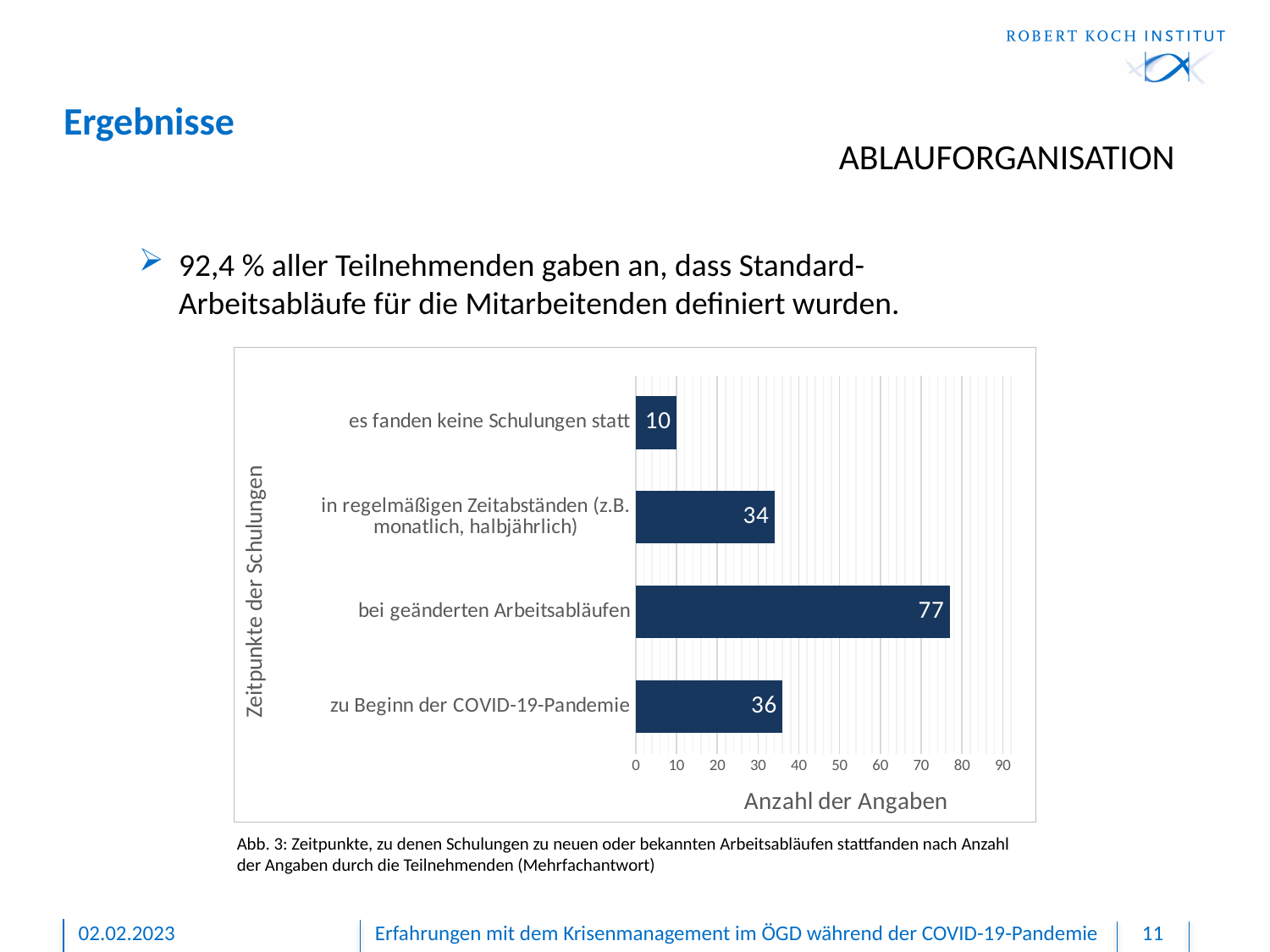
What is the difference between the values for "bei geänderten Arbeitsabläufen" and "zu Beginn der COVID-19-Pandemie"? 41 What is the value for "zu Beginn der COVID-19-Pandemie"? 36 What is the value for "bei geänderten Arbeitsabläufen"? 77 Which category has the highest value? bei geänderten Arbeitsabläufen What is the value for "in regelmäßigen Zeitabständen (z.B. monatlich, halbjährlich)"? 34 What kind of chart is shown on the slide? bar chart Which is larger: the value for "zu Beginn der COVID-19-Pandemie" or for "in regelmäßigen Zeitabständen (z.B. monatlich, halbjährlich)"? zu Beginn der COVID-19-Pandemie How many categories are shown in the chart? 4 What is the value for "es fanden keine Schulungen statt"? 10 Is the value for "bei geänderten Arbeitsabläufen" greater or less than 70? greater Which category has the lowest value? es fanden keine Schulungen statt What is the label of the horizontal axis of the chart? Anzahl der Angaben